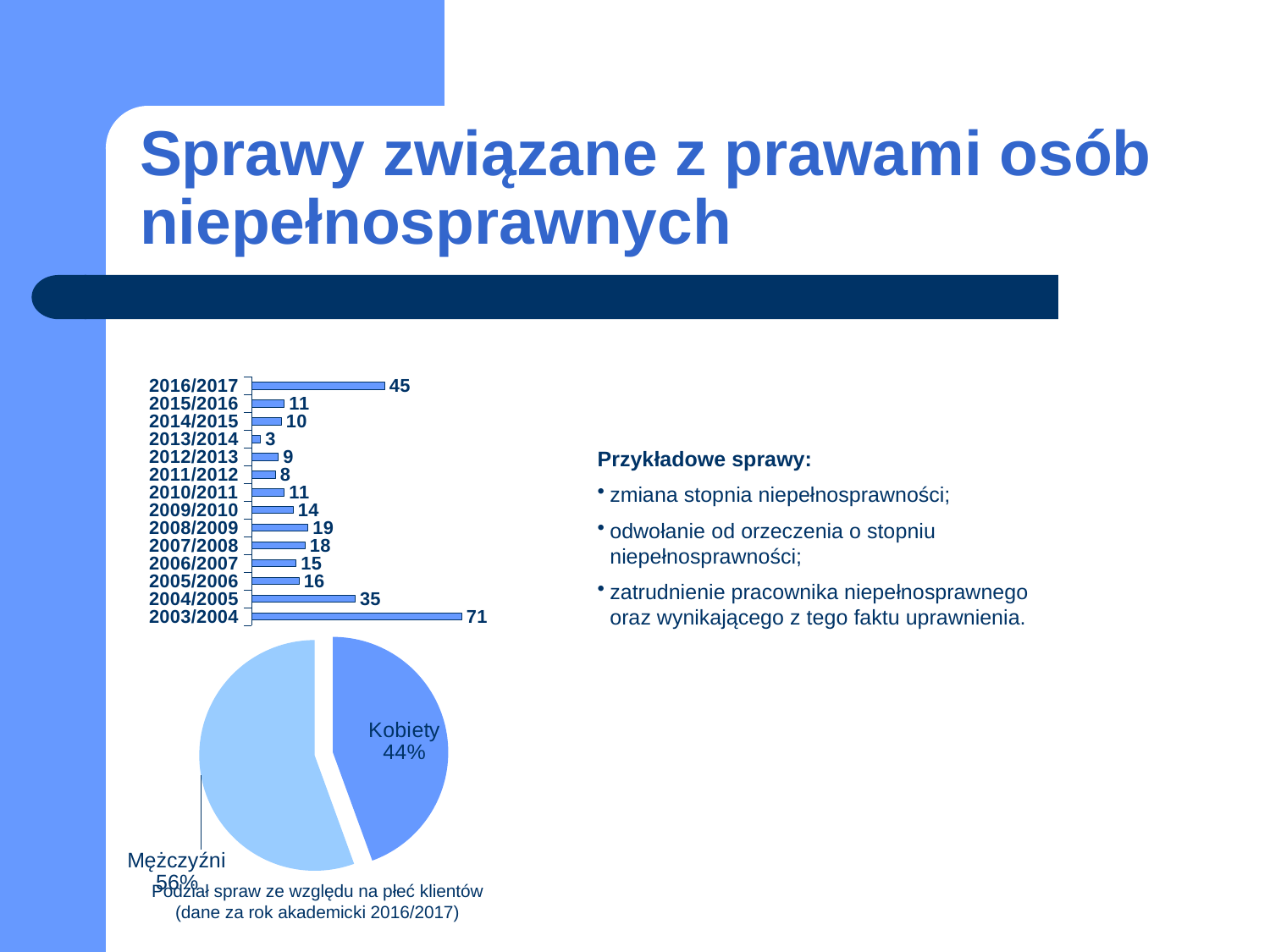
In the bar chart, which year has the highest value? 2003/2004 In the pie chart 'Podział spraw ze względu na płeć klientów', what share is Kobiety? 44% In the bar chart, what is the difference between the values for 2003/2004 and 2004/2005? 36 In the bar chart, what is the value for 2003/2004? 71 What kind of chart is the chart at the top left of the slide? bar chart In the bar chart, which year has the lowest value? 2013/2014 In the bar chart, which is larger, the value for 2008/2009 or the value for 2007/2008? 2008/2009 In the pie chart 'Podział spraw ze względu na płeć klientów', which slice is larger, Kobiety or Mężczyźni? Mężczyźni How many years are shown in the bar chart? 14 In the bar chart, what is the value for 2013/2014? 3 In the pie chart 'Podział spraw ze względu na płeć klientów', what share is Mężczyźni? 56% In the bar chart, what is the value for 2016/2017? 45